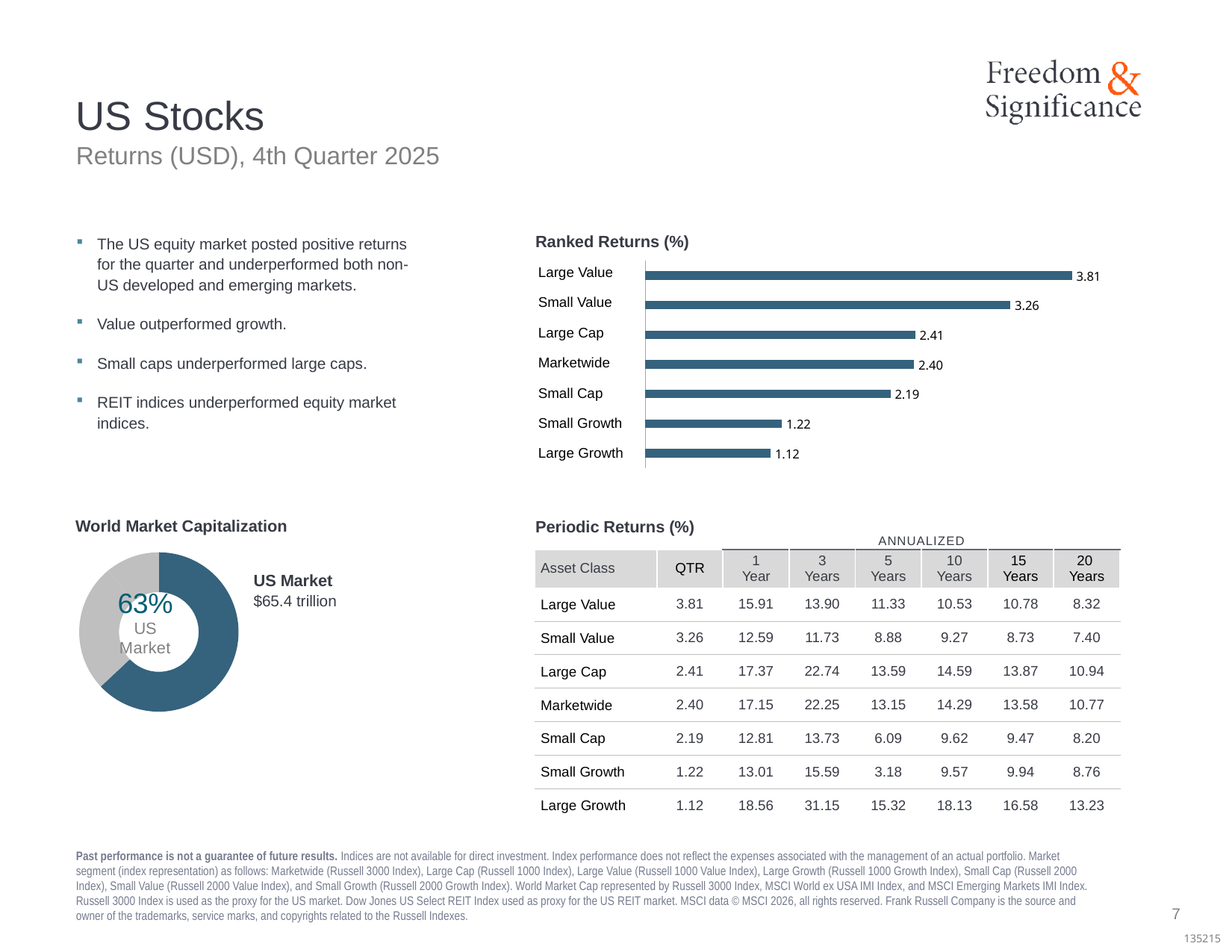
In the Ranked Returns (%) chart, which is larger, Small Cap or Small Growth? Small Cap In the Ranked Returns (%) chart, what is the difference between Large Value and Small Value? 0.55 In the Ranked Returns (%) chart, what is the value for Marketwide? 2.40 In the Ranked Returns (%) chart, what is the difference between Small Cap and Large Growth? 1.07 What kind of chart is the World Market Capitalization chart? Pie chart (donut) What kind of chart is the Ranked Returns (%) chart? Bar chart How many categories are shown in the Ranked Returns (%) chart? 7 In the Ranked Returns (%) chart, which category has the lowest value? Large Growth In the Ranked Returns (%) chart, what is the value for Large Value? 3.81 In the Ranked Returns (%) chart, which category has the highest value? Large Value In the World Market Capitalization chart, what share of world market capitalization is the US Market? 63% In the Ranked Returns (%) chart, what is the value for Small Growth? 1.22